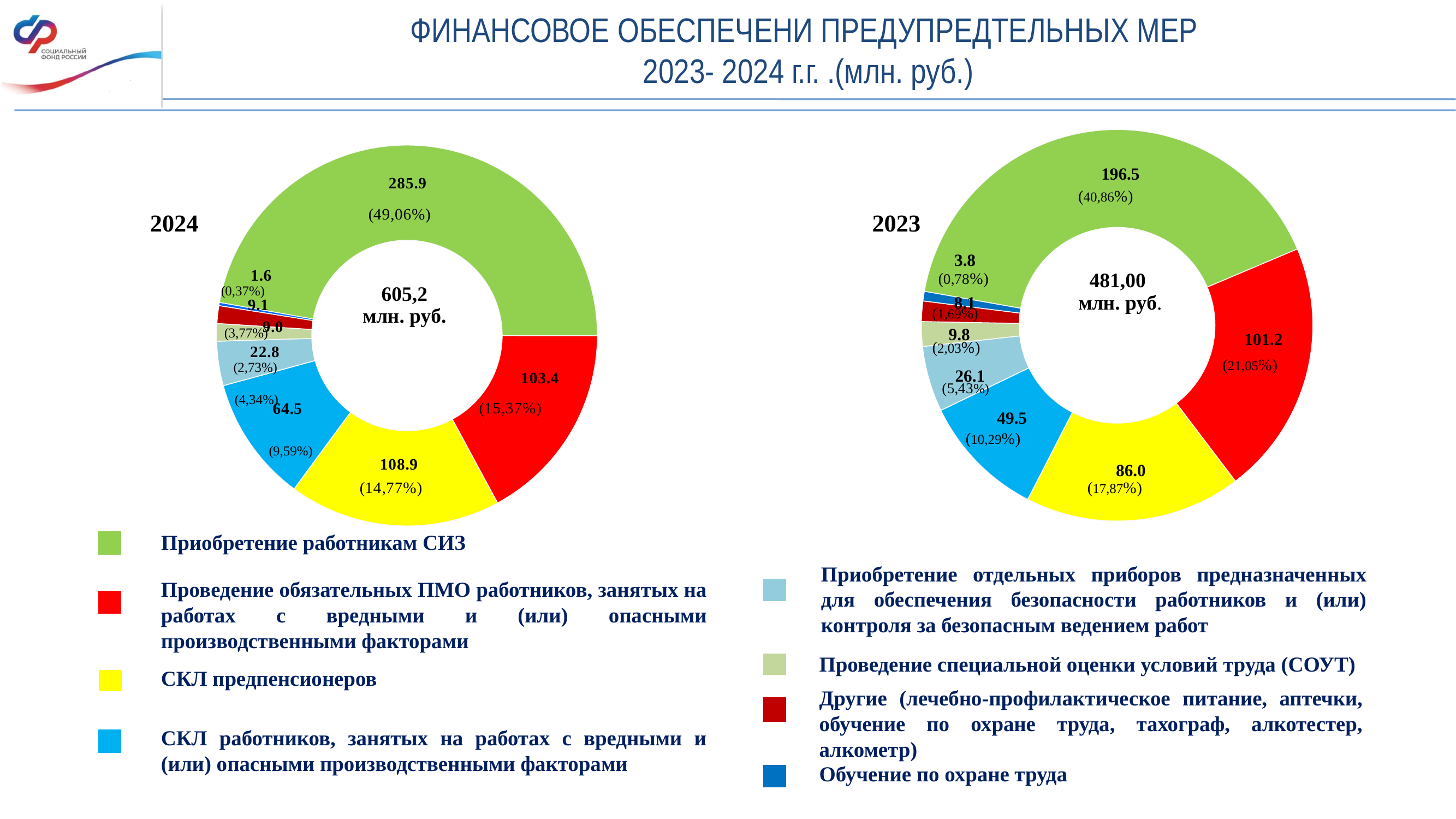
In the 2024 chart, what is the value for Проведение обязательных ПМО работников, занятых на работах с вредными и (или) опасными производственными факторами? 103.4 In the 2023 chart, what is the difference between the values for Приобретение работникам СИЗ and СКЛ предпенсионеров? 110.5 In the 2023 chart, what is the value for Приобретение работникам СИЗ? 196.5 What kind of chart is used on this slide? Pie (donut) chart What total is shown in the centre of the 2024 chart? 605,2 млн. руб. In the 2023 chart, which category has the largest slice? Приобретение работникам СИЗ In the 2024 chart, what share of the total does Приобретение работникам СИЗ account for? 49,06% In the 2024 chart, what is the value for Приобретение работникам СИЗ? 285.9 In the 2024 chart, which is larger: the value for СКЛ предпенсионеров or the value for Проведение обязательных ПМО работников? СКЛ предпенсионеров In the 2023 chart, which category has the smallest slice? Обучение по охране труда In the 2023 chart, what is the value for СКЛ предпенсионеров? 86.0 In the 2023 chart, what share of the total does Проведение специальной оценки условий труда (СОУТ) account for? 2,03%